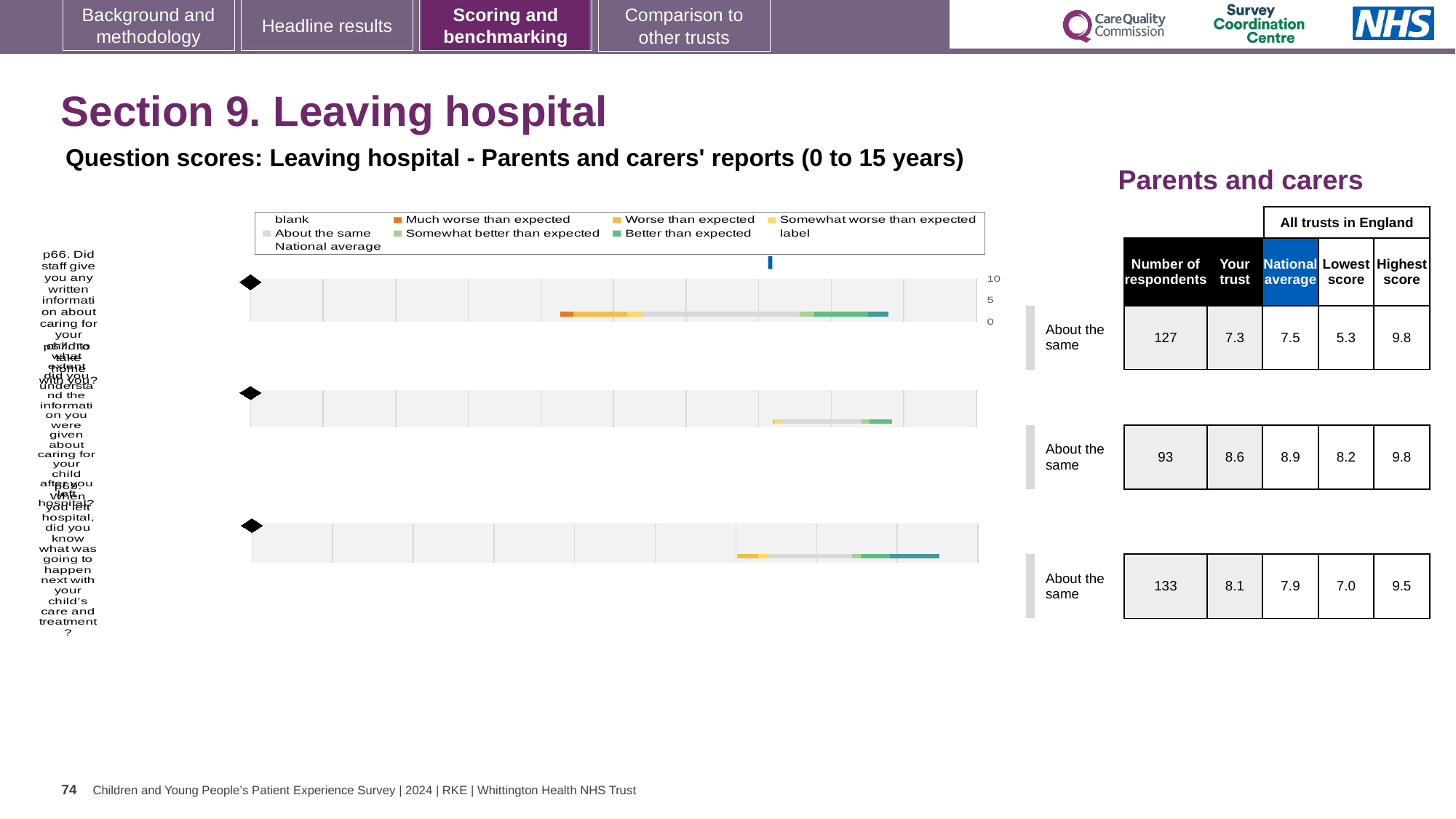
For the middle question row, what is the national average score? 8.9 In the legend, which colour represents 'Much worse than expected'? orange What is the title of the table on the right of the slide? Parents and carers For the bottom question row, what is the lowest score among all trusts in England? 7.0 For the top question row (p66), what is the 'Your trust' score? 7.3 For the middle question row, which is larger: the 'Your trust' score or the national average? National average For the top question row (p66), what is the number of respondents? 127 How many question rows (bar charts) are shown on the slide? 3 For the top question row, what is the difference between the national average and the 'Your trust' score? 0.2 Which question row has the highest number of respondents? the bottom row (133) What benchmark category is shown for all three question rows? About the same What kind of chart is used to show the question scores on this slide? bar chart